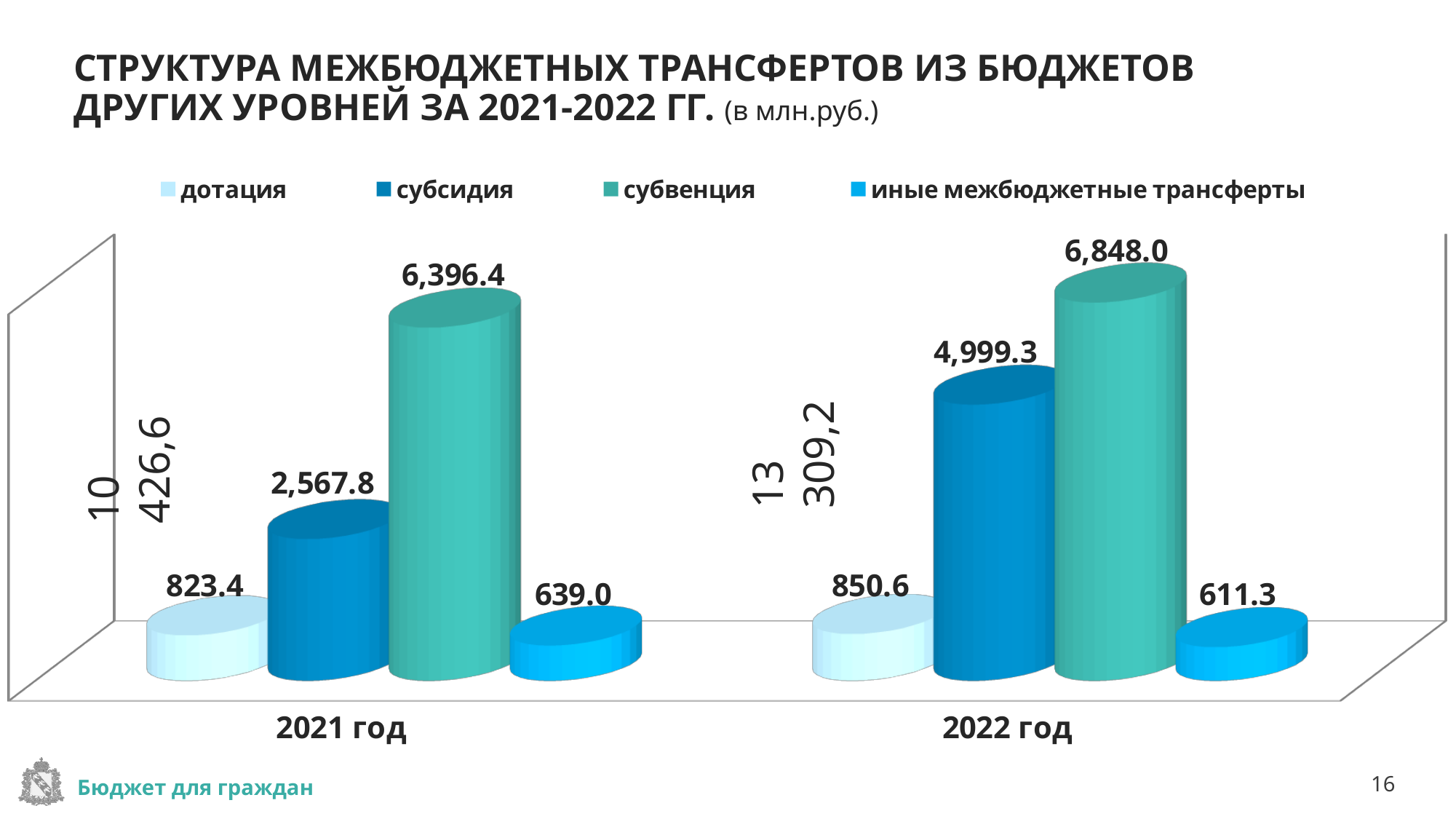
Which is larger: иные межбюджетные трансферты in 2021 год or in 2022 год? 2021 год What is the value for субвенция in 2021 год? 6,396.4 What is the value for субсидия in 2022 год? 4,999.3 What is the difference between the субсидия values for 2022 год and 2021 год? 2,431.5 What kind of chart is shown on the slide? bar chart What is the value for иные межбюджетные трансферты in 2021 год? 639.0 What is the total of all four series for 2021 год, as printed on the slide? 10 426,6 Which series has the highest value in 2022 год? субвенция Which series has the lowest value in 2021 год? иные межбюджетные трансферты What is the value for дотация in 2022 год? 850.6 What is the difference between the субвенция values for 2022 год and 2021 год? 451.6 How many series does the legend list? 4